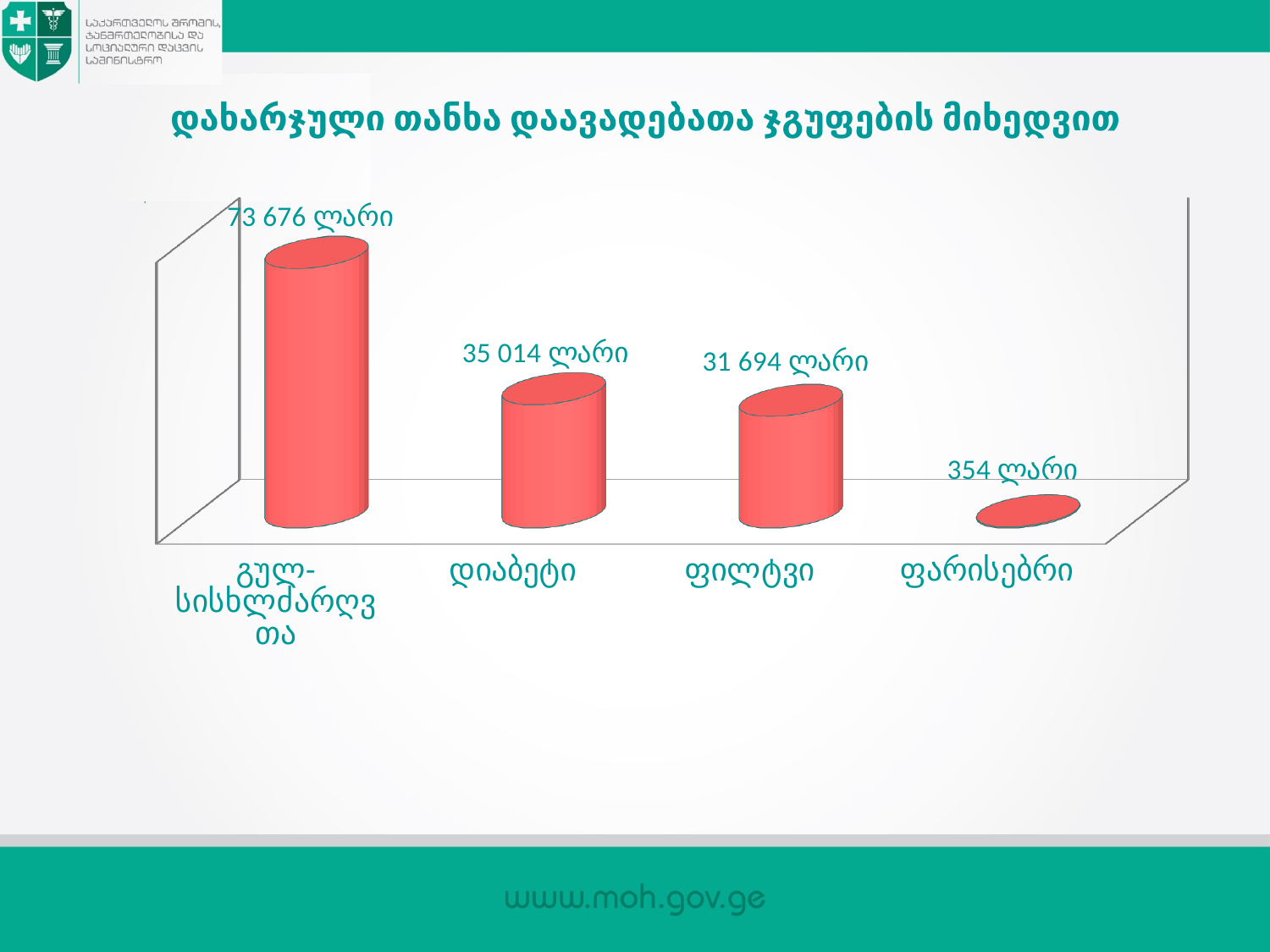
Which is larger, the value for დიაბეტი or the value for ფილტვი? დიაბეტი How many categories are shown in the chart? 4 What value is shown for გულ-სისხლძარღვთა? 73 676 ლარი What value is shown for ფარისებრი? 354 ლარი What is the title of the chart? დახარჯული თანხა დაავადებათა ჯგუფების მიხედვით Which category has the highest value? გულ-სისხლძარღვთა What is the difference between the values for გულ-სისხლძარღვთა and დიაბეტი? 38 662 ლარი What value is shown for ფილტვი? 31 694 ლარი Which category has the lowest value? ფარისებრი What value is shown for დიაბეტი? 35 014 ლარი What kind of chart is shown on the slide? bar chart What is the difference between the values for დიაბეტი and ფილტვი? 3 320 ლარი